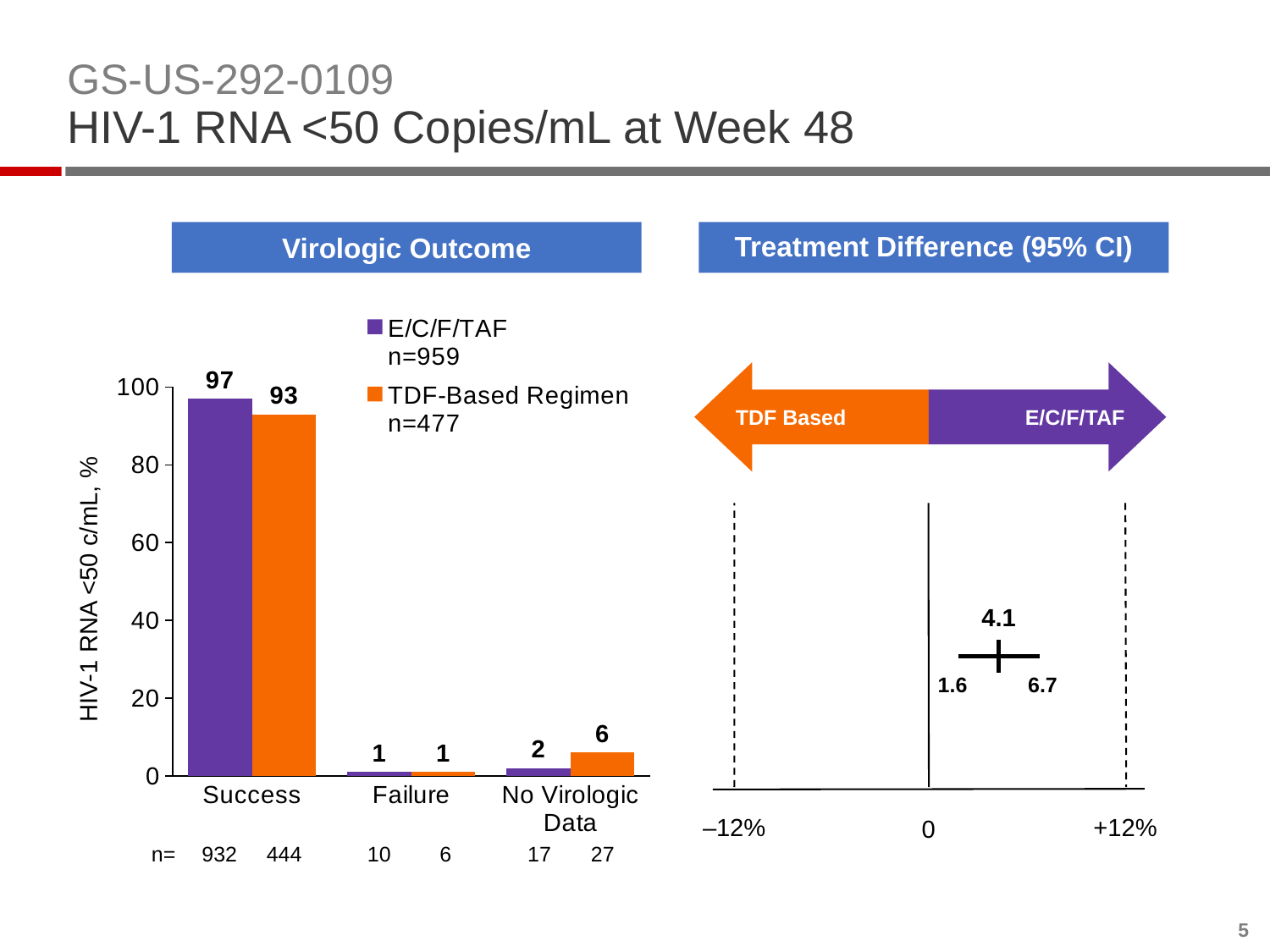
In the Virologic Outcome chart, what is the difference between the E/C/F/TAF and TDF-Based Regimen values in the Success category? 4 In the Virologic Outcome chart, what is the value for the TDF-Based Regimen in the Success category? 93 In the Virologic Outcome chart, what is the value for E/C/F/TAF in the Success category? 97 How many series does the legend of the Virologic Outcome chart list? 2 In the Virologic Outcome chart, what is the value for E/C/F/TAF in the No Virologic Data category? 2 What kind of chart is the Virologic Outcome chart? Bar chart In the Virologic Outcome chart, what is the value for the TDF-Based Regimen in the No Virologic Data category? 6 How many categories are shown on the x axis of the Virologic Outcome chart? 3 In the Virologic Outcome chart, which category has the lowest value for the TDF-Based Regimen? Failure In the Treatment Difference (95% CI) chart, what is the point estimate of the treatment difference? 4.1 In the Virologic Outcome chart, which series has the larger value in the No Virologic Data category? TDF-Based Regimen In the Virologic Outcome chart, which category has the highest value for E/C/F/TAF? Success